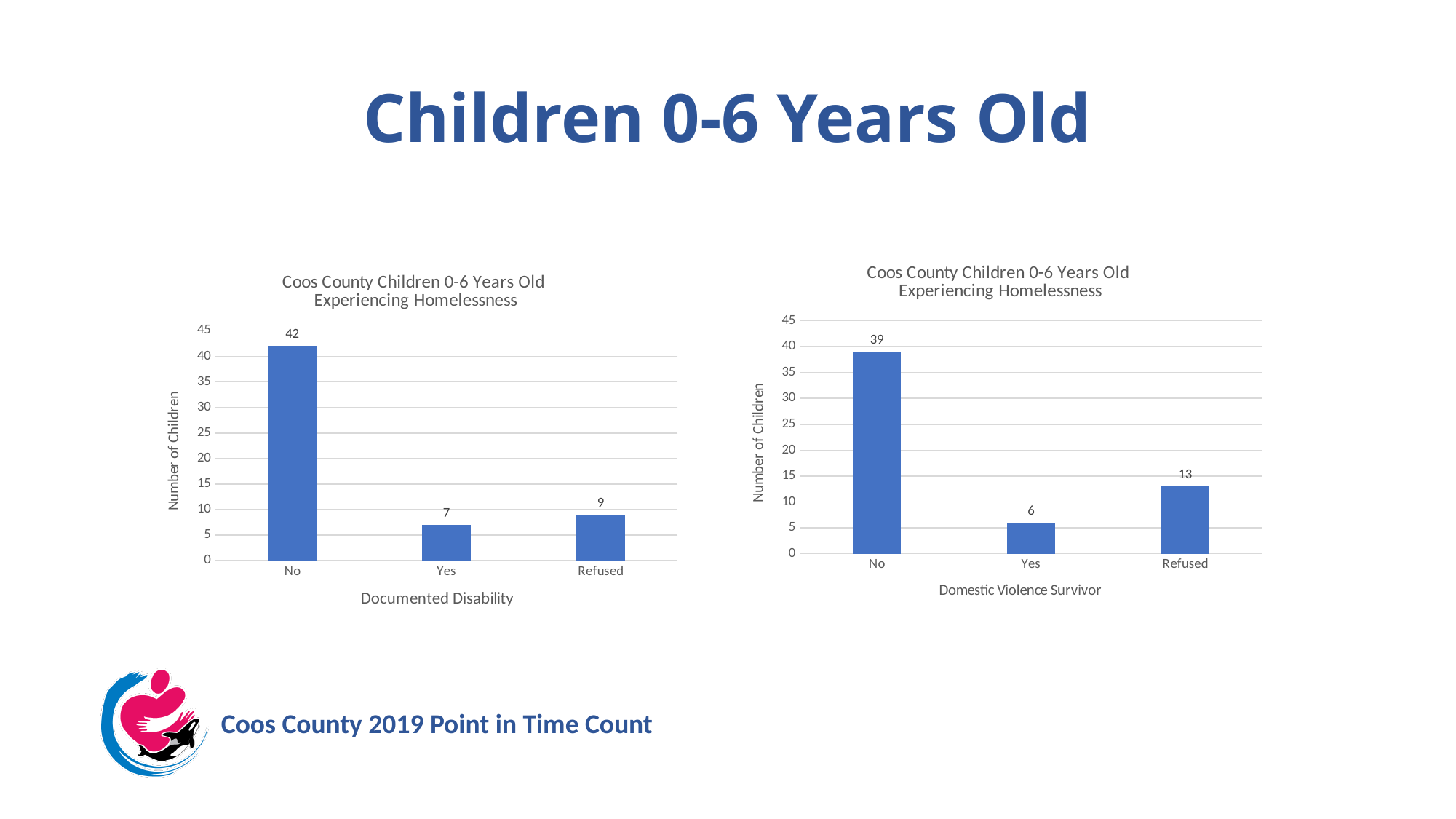
In the left chart (Documented Disability), which category has the highest value? No In the right chart (Domestic Violence Survivor), what is the difference between the values for Refused and Yes? 7 What kind of chart is the right chart (Domestic Violence Survivor)? Bar chart In the left chart (Documented Disability), what is the value for No? 42 In the left chart (Documented Disability), what is the value for Yes? 7 How many categories are shown on the x axis of the left chart (Documented Disability)? 3 In the left chart (Documented Disability), what is the difference between the values for No and Refused? 33 In the right chart (Domestic Violence Survivor), what is the value for Yes? 6 In the right chart (Domestic Violence Survivor), what is the value for Refused? 13 In the right chart (Domestic Violence Survivor), which category has the lowest value? Yes What is the x-axis label of the right chart? Domestic Violence Survivor In the right chart (Domestic Violence Survivor), which is larger, the value for Yes or the value for Refused? Refused